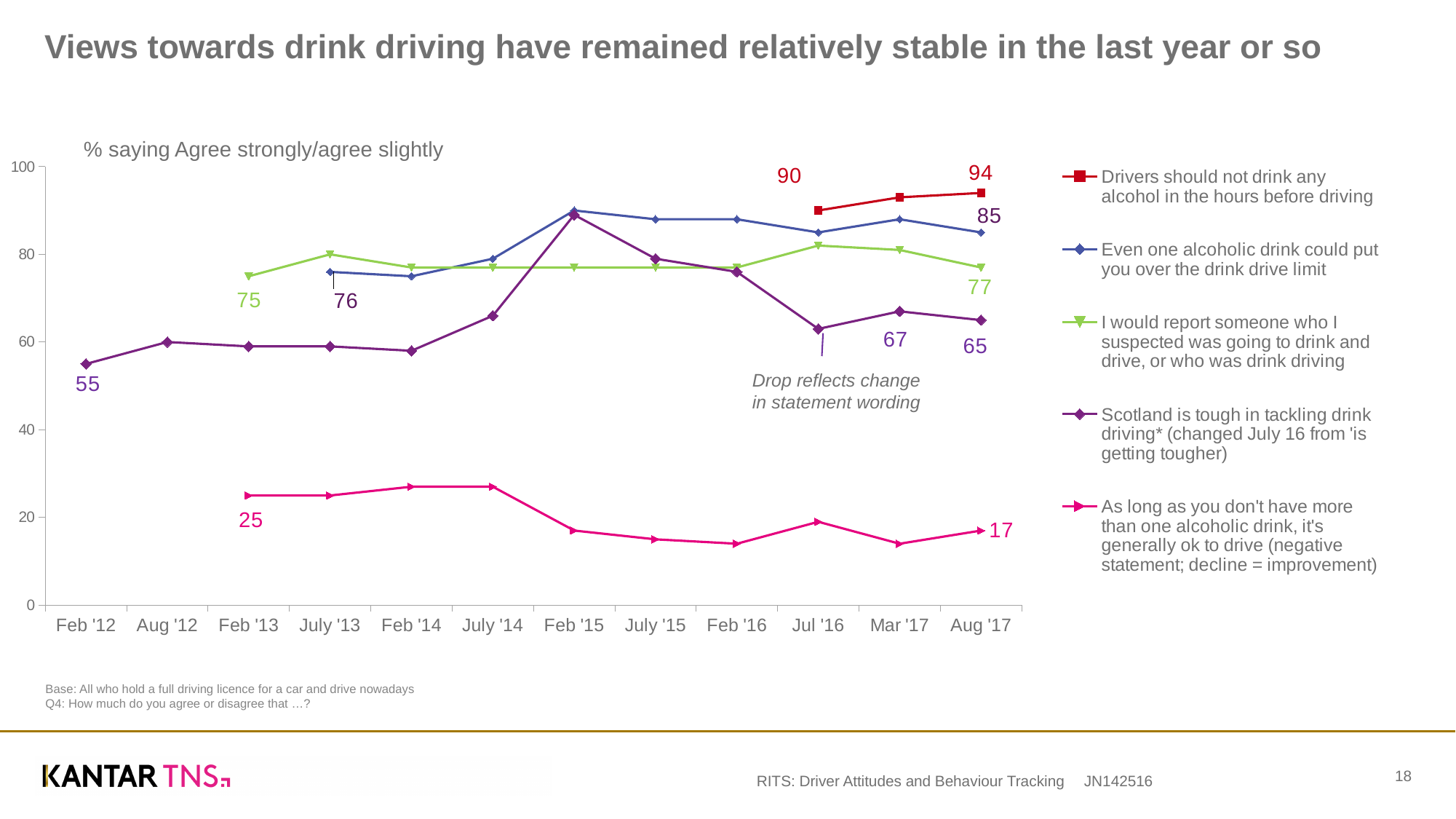
What is the value for 'Drivers should not drink any alcohol in the hours before driving' at Aug '17? 94 By how much did 'Drivers should not drink any alcohol in the hours before driving' increase from Jul '16 to Aug '17? 4 What is the value for 'Scotland is tough in tackling drink driving' at Feb '12? 55 What is the value for 'Drivers should not drink any alcohol in the hours before driving' at Jul '16? 90 Which series has the highest value at Aug '17? Drivers should not drink any alcohol in the hours before driving What is the value for 'I would report someone who I suspected was going to drink and drive, or who was drink driving' at Feb '13? 75 Is the value for 'As long as you don't have more than one alcoholic drink, it's generally ok to drive' at Feb '15 greater or less than 20? less What kind of chart is shown on the slide? Line chart How many series does the legend list? 5 What is the value for 'As long as you don't have more than one alcoholic drink, it's generally ok to drive' at Aug '17? 17 Which series has the lowest value at Aug '17? As long as you don't have more than one alcoholic drink, it's generally ok to drive What is the value for 'Even one alcoholic drink could put you over the drink drive limit' at Aug '17? 85